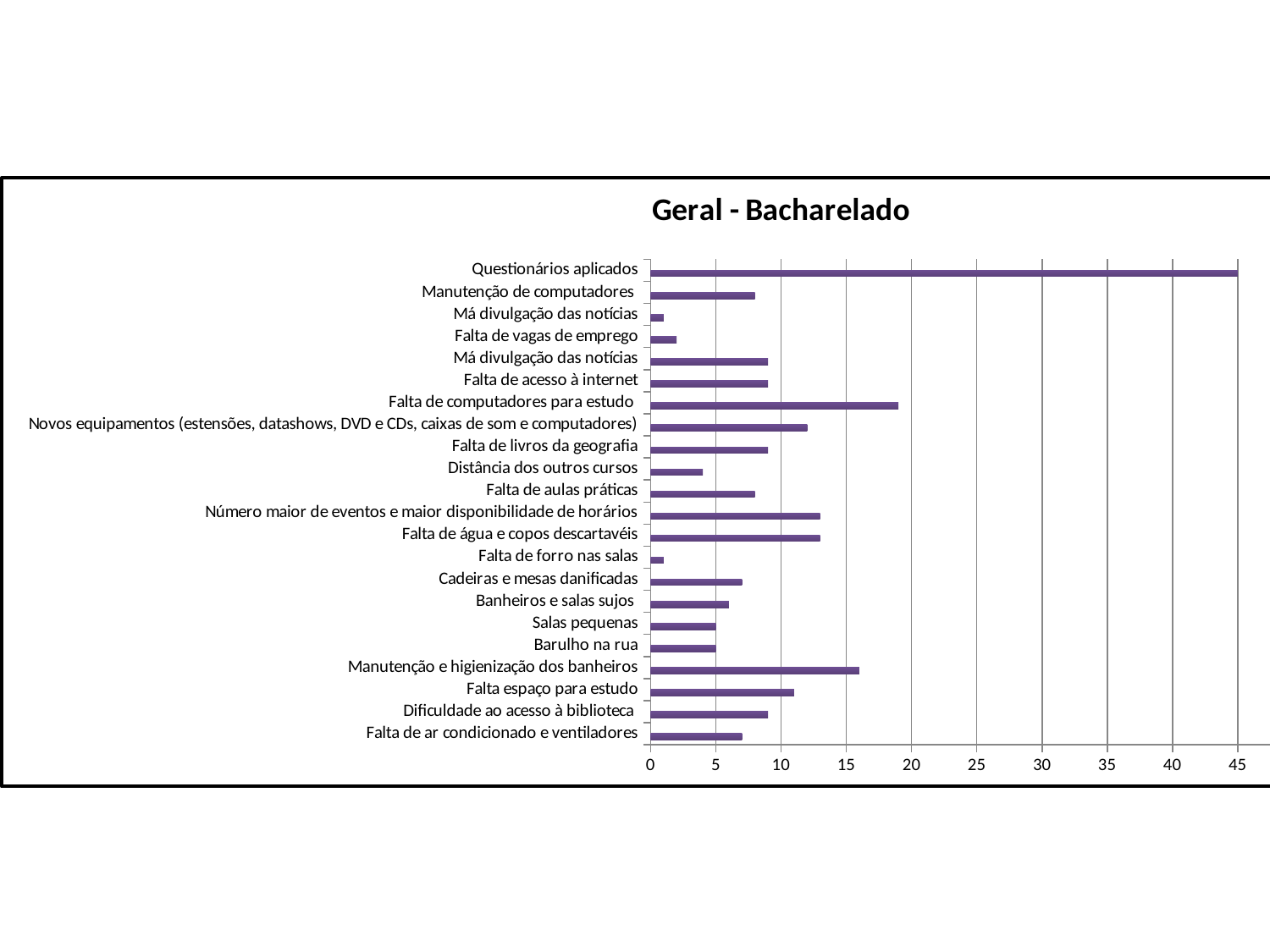
What is the value for Questionários aplicados? 45 Is the value for Distância dos outros cursos greater or less than 5? less Which is larger: the value for Falta de água e copos descartavéis or the value for Falta de forro nas salas? Falta de água e copos descartavéis Is the value for Falta de computadores para estudo greater or less than 15? greater What type of chart is shown on the slide? bar chart Which is larger: the value for Falta de computadores para estudo or the value for Falta espaço para estudo? Falta de computadores para estudo What is the value for Barulho na rua? 5 Is the value for Manutenção e higienização dos banheiros greater or less than 10? greater How many categories are plotted in the chart? 22 Which category has the highest value? Questionários aplicados What is the title of the chart? Geral - Bacharelado What is the value for Salas pequenas? 5